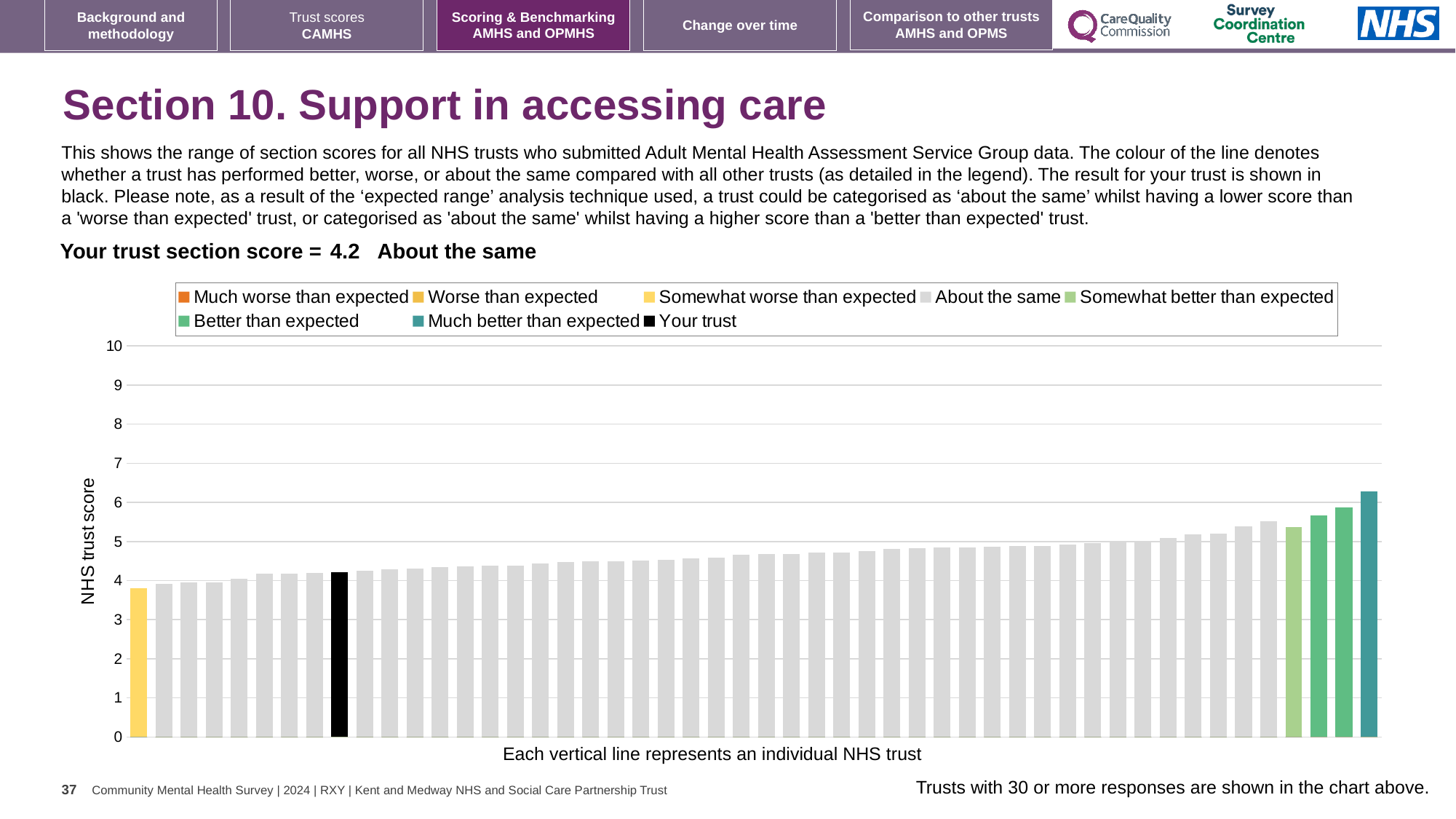
Is the value of the shortest bar in the chart greater or less than 4? less How many entries does the chart legend list? 8 Which bar is taller: the black 'Your trust' bar or the teal 'Much better than expected' bar at the far right? the teal 'Much better than expected' bar What kind of chart is shown on the slide? bar chart Do the bar values rise or fall from left to right along the x axis? rise Is the value of the black 'Your trust' bar greater or less than 4? greater Which bar is shorter: the yellow bar at the far left or the black 'Your trust' bar? the yellow bar at the far left What is the highest value shown on the y axis of the chart? 10 What is the label of the y axis of the chart? NHS trust score What is the section score for your trust shown on the slide? 4.2 Is the value of the tallest bar in the chart greater or less than 6? greater